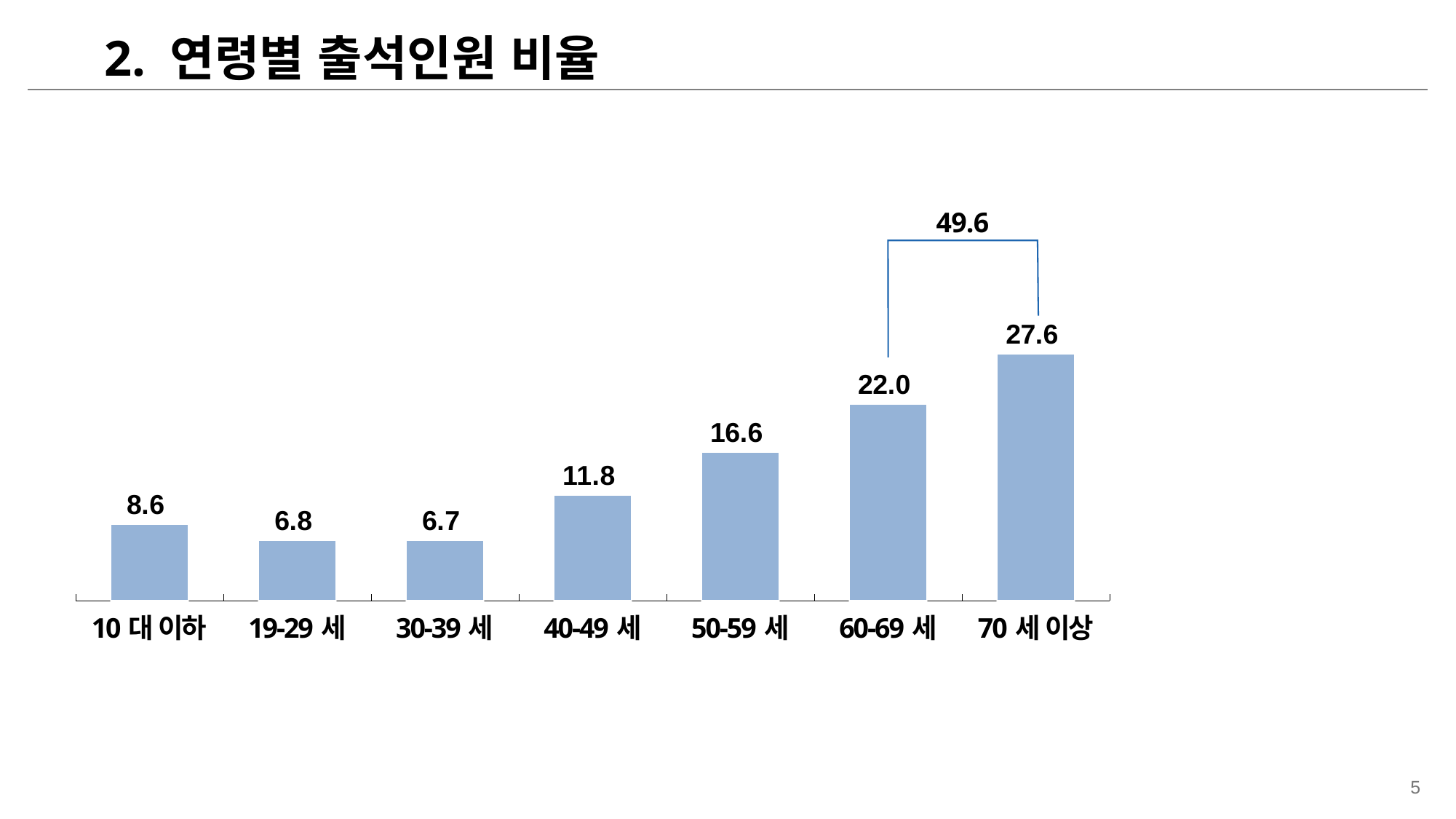
Which is larger, the value for 10 대 이하 or the value for 19-29 세? 10 대 이하 What kind of chart is shown on the slide? bar chart Do the values generally rise or fall from 30-39 세 to 70 세 이상? rise Which age group has the highest value? 70 세 이상 What is the value for 70 세 이상? 27.6 What is the difference between the values for 70 세 이상 and 60-69 세? 5.6 What is the value for 50-59 세? 16.6 What is the difference between the values for 40-49 세 and 19-29 세? 5.0 What is the value for 10 대 이하? 8.6 What combined value is shown by the bracket above the 60-69 세 and 70 세 이상 bars? 49.6 Which age group has the lowest value? 30-39 세 How many age groups are shown on the chart? 7